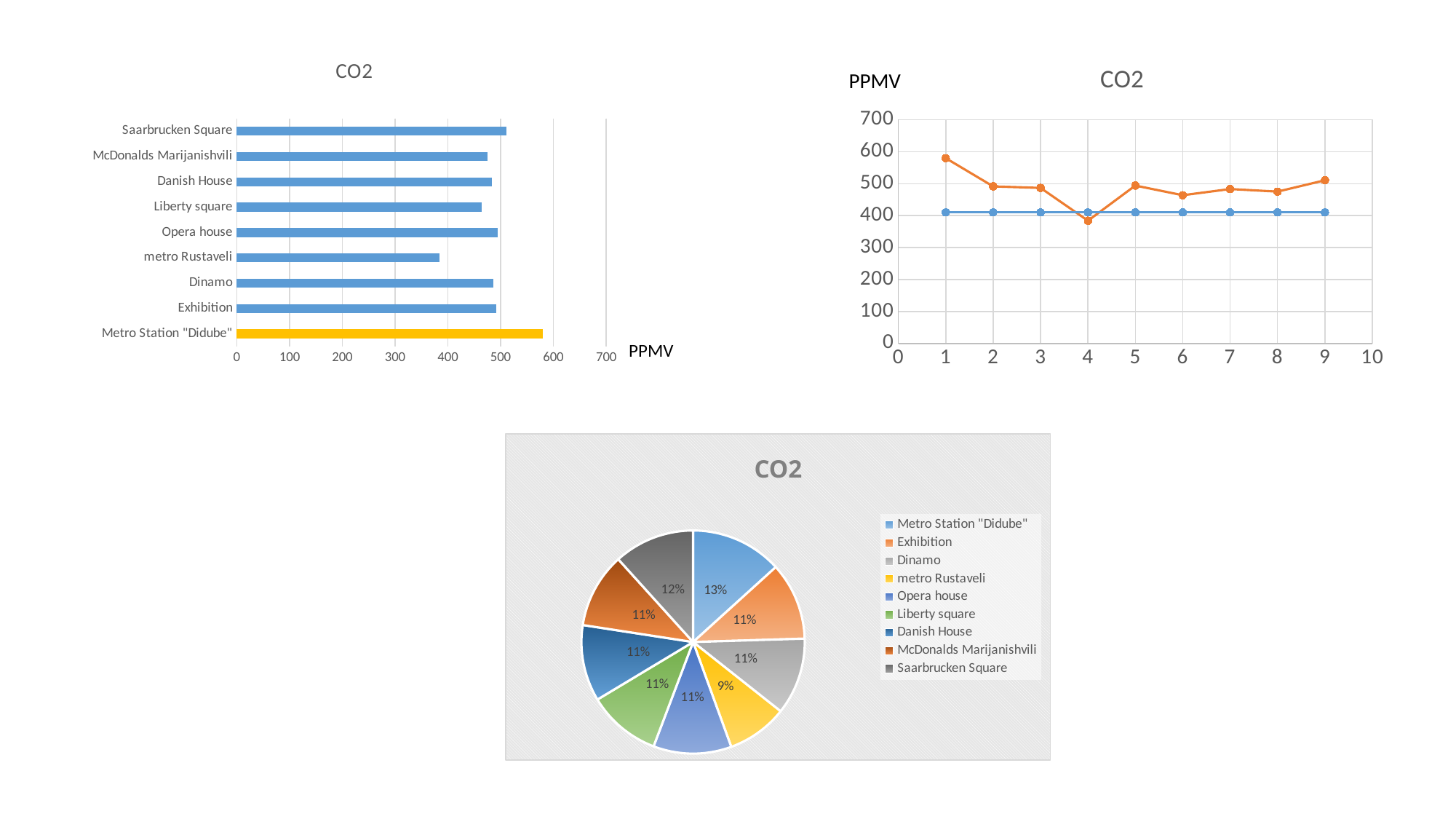
In the pie chart at the bottom, what share does Metro Station "Didube" have? 13% How many locations are shown in the bar chart at the top left? 9 In the bar chart at the top left, which location has the highest CO2 value? Metro Station "Didube" In the bar chart at the top left, is the value for Metro Station "Didube" greater or less than 500? greater In the bar chart at the top left, is the value for metro Rustaveli greater or less than 400? less In the pie chart at the bottom, which location has the smallest share? metro Rustaveli What kind of chart is the chart at the top left of the slide? bar chart What kind of chart is the chart at the top right of the slide? line chart In the line chart at the top right, is the orange series value at x = 4 greater or less than 400? less In the bar chart at the top left, which location has the lowest CO2 value? metro Rustaveli In the bar chart at the top left, which bar is coloured differently from the others? Metro Station "Didube"